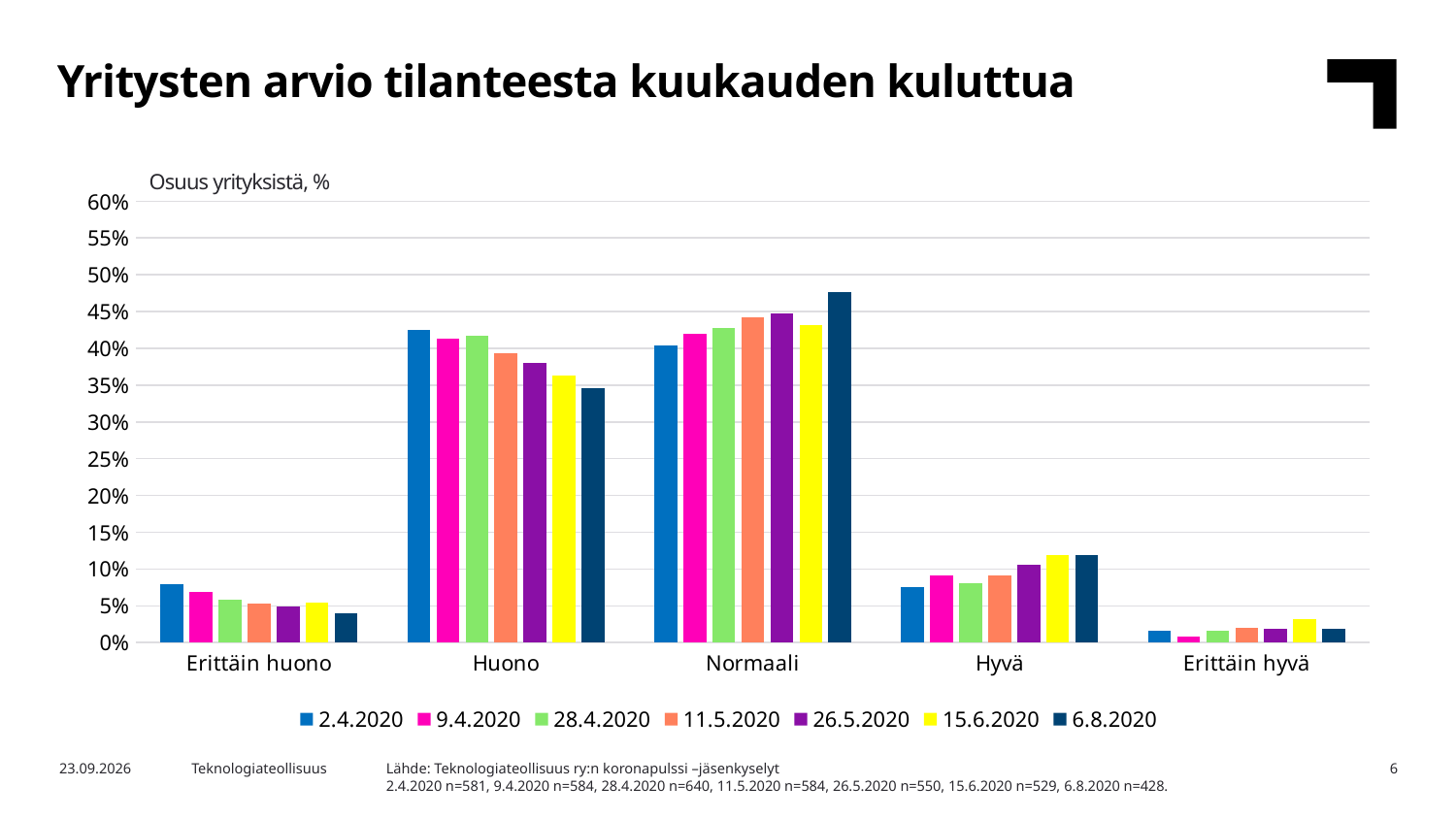
For 2.4.2020, which is larger: Huono or Normaali? Huono What kind of chart is shown on the slide? bar chart How many categories are shown on the x axis? 5 Which category has the highest value for 6.8.2020? Normaali How many series does the legend list? 7 Which category has the lowest value for 2.4.2020? Erittäin hyvä Do the values for Huono rise or fall from 2.4.2020 to 6.8.2020? fall Is the value for Erittäin huono on 2.4.2020 greater or less than 10%? less Is the value for Huono on 6.8.2020 greater or less than 40%? less For 6.8.2020, which is larger: Huono or Normaali? Normaali What is the label shown above the y axis? Osuus yrityksistä, % Is the value for Normaali on 6.8.2020 greater or less than 45%? greater